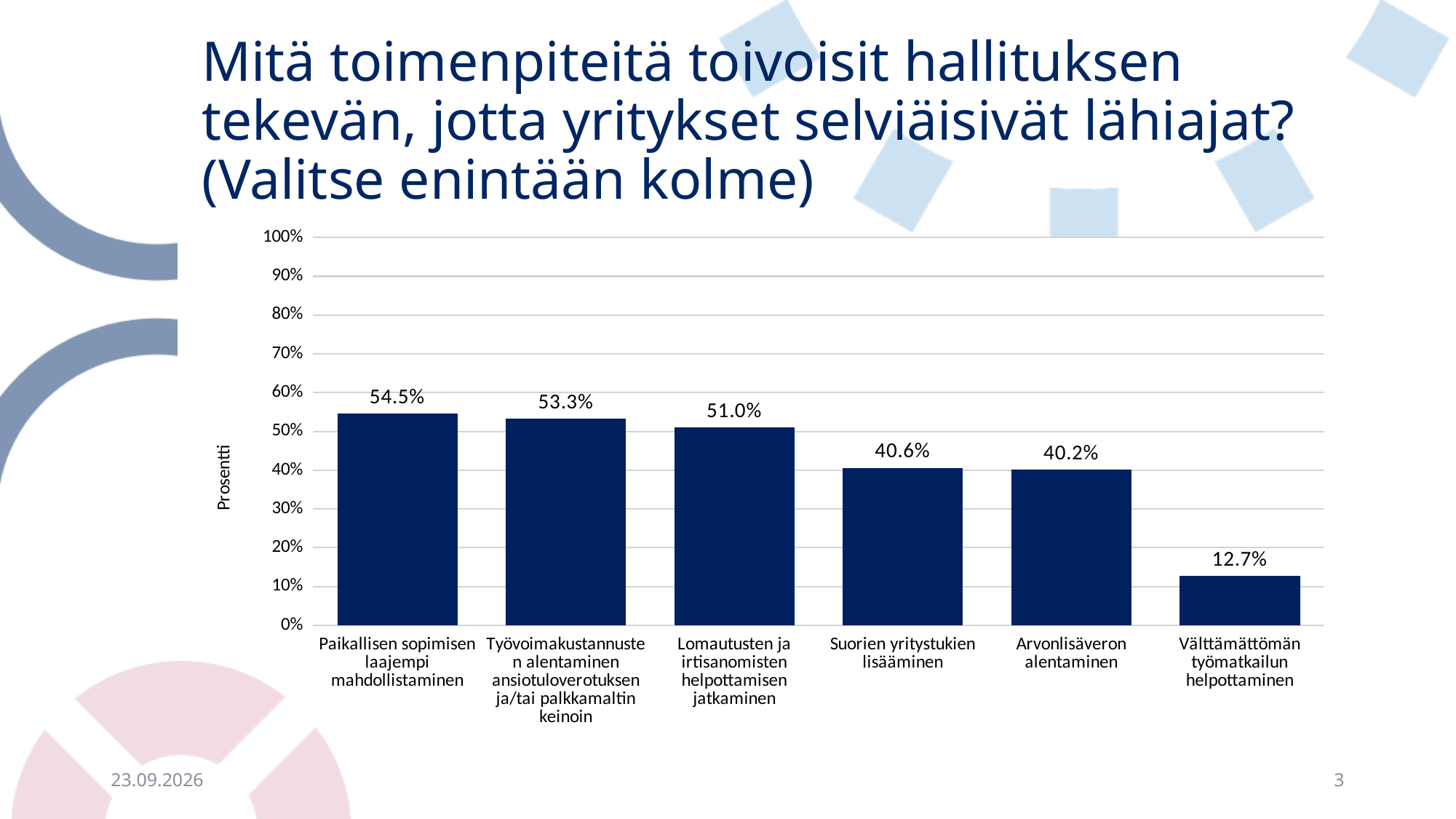
What is the value for "Lomautusten ja irtisanomisten helpottamisen jatkaminen"? 51.0% What is the difference between the values for "Suorien yritystukien lisääminen" and "Arvonlisäveron alentaminen"? 0.4% Is the value for "Työvoimakustannusten alentaminen ansiotuloverotuksen ja/tai palkkamaltin keinoin" greater or less than 50%? greater How many categories are shown in the chart? 6 What is the value for "Arvonlisäveron alentaminen"? 40.2% What is the value for "Välttämättömän työmatkailun helpottaminen"? 12.7% Which category has the lowest value? Välttämättömän työmatkailun helpottaminen Which is larger: the value for "Lomautusten ja irtisanomisten helpottamisen jatkaminen" or the value for "Suorien yritystukien lisääminen"? Lomautusten ja irtisanomisten helpottamisen jatkaminen What is the difference between the values for "Paikallisen sopimisen laajempi mahdollistaminen" and "Välttämättömän työmatkailun helpottaminen"? 41.8% What kind of chart is shown on the slide? bar chart What is the value for "Paikallisen sopimisen laajempi mahdollistaminen"? 54.5% Which category has the highest value? Paikallisen sopimisen laajempi mahdollistaminen